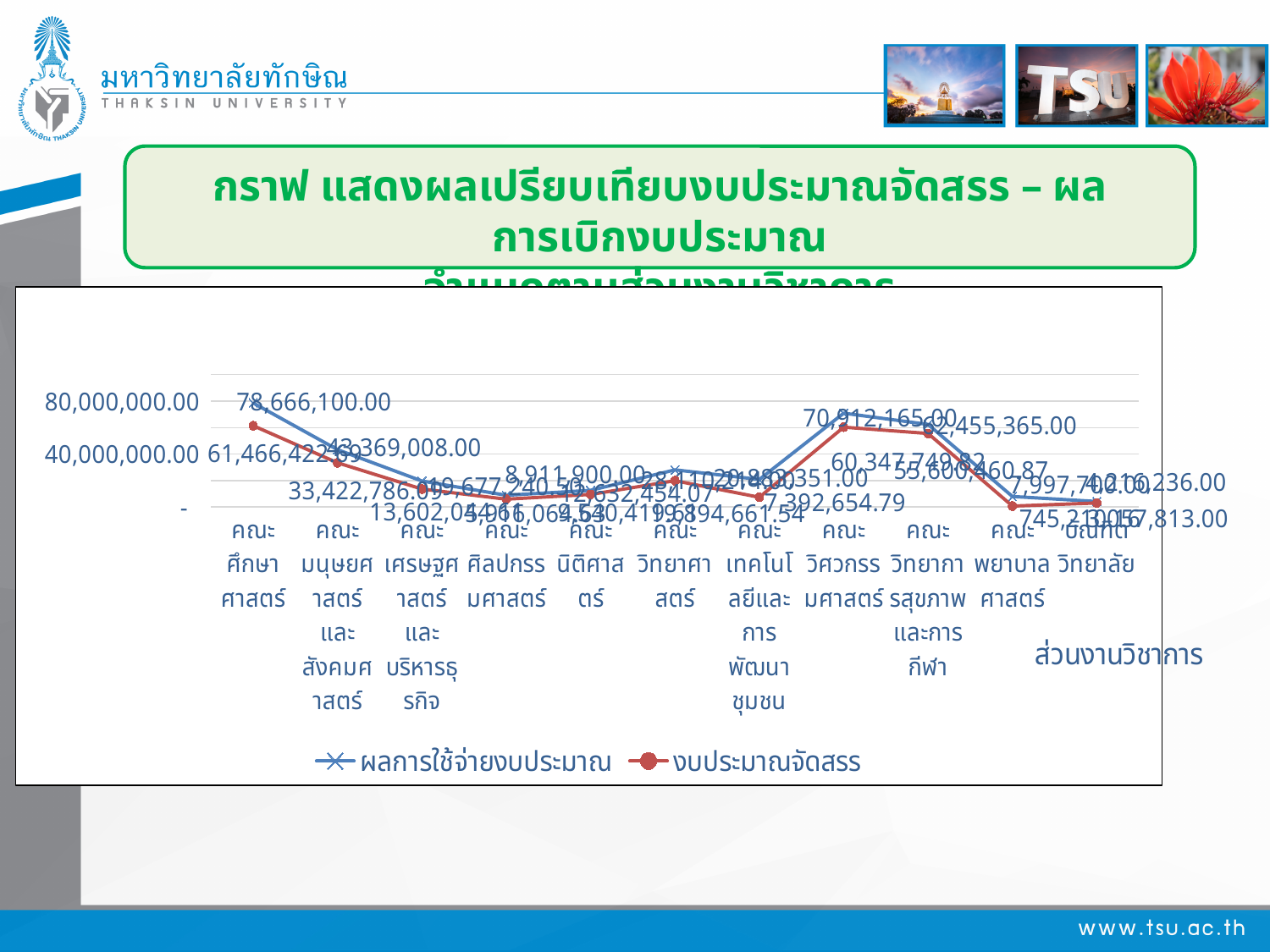
How many faculties (categories) are plotted along the x axis? 11 What is the งบประมาณจัดสรร value for คณะเทคโนโลยีและการพัฒนาชุมชน? 7,392,654.79 What is the ผลการใช้จ่ายงบประมาณ value for คณะศึกษาศาสตร์? 78,666,100.00 How many series does the chart legend list? 2 What is the งบประมาณจัดสรร value for คณะศึกษาศาสตร์? 61,466,422.69 What is the ผลการใช้จ่ายงบประมาณ value for คณะวิศวกรรมศาสตร์? 70,912,165.00 Which faculty has the lowest งบประมาณจัดสรร? คณะพยาบาลศาสตร์ For ผลการใช้จ่ายงบประมาณ, which is larger: คณะมนุษยศาสตร์และสังคมศาสตร์ or คณะวิศวกรรมศาสตร์? คณะวิศวกรรมศาสตร์ Is the ผลการใช้จ่ายงบประมาณ value for คณะนิติศาสตร์ greater or less than 40,000,000.00? less What is the difference between ผลการใช้จ่ายงบประมาณ and งบประมาณจัดสรร for คณะศึกษาศาสตร์? 17,199,677.31 What kind of chart is shown on the slide? line chart Which faculty has the highest ผลการใช้จ่ายงบประมาณ? คณะศึกษาศาสตร์